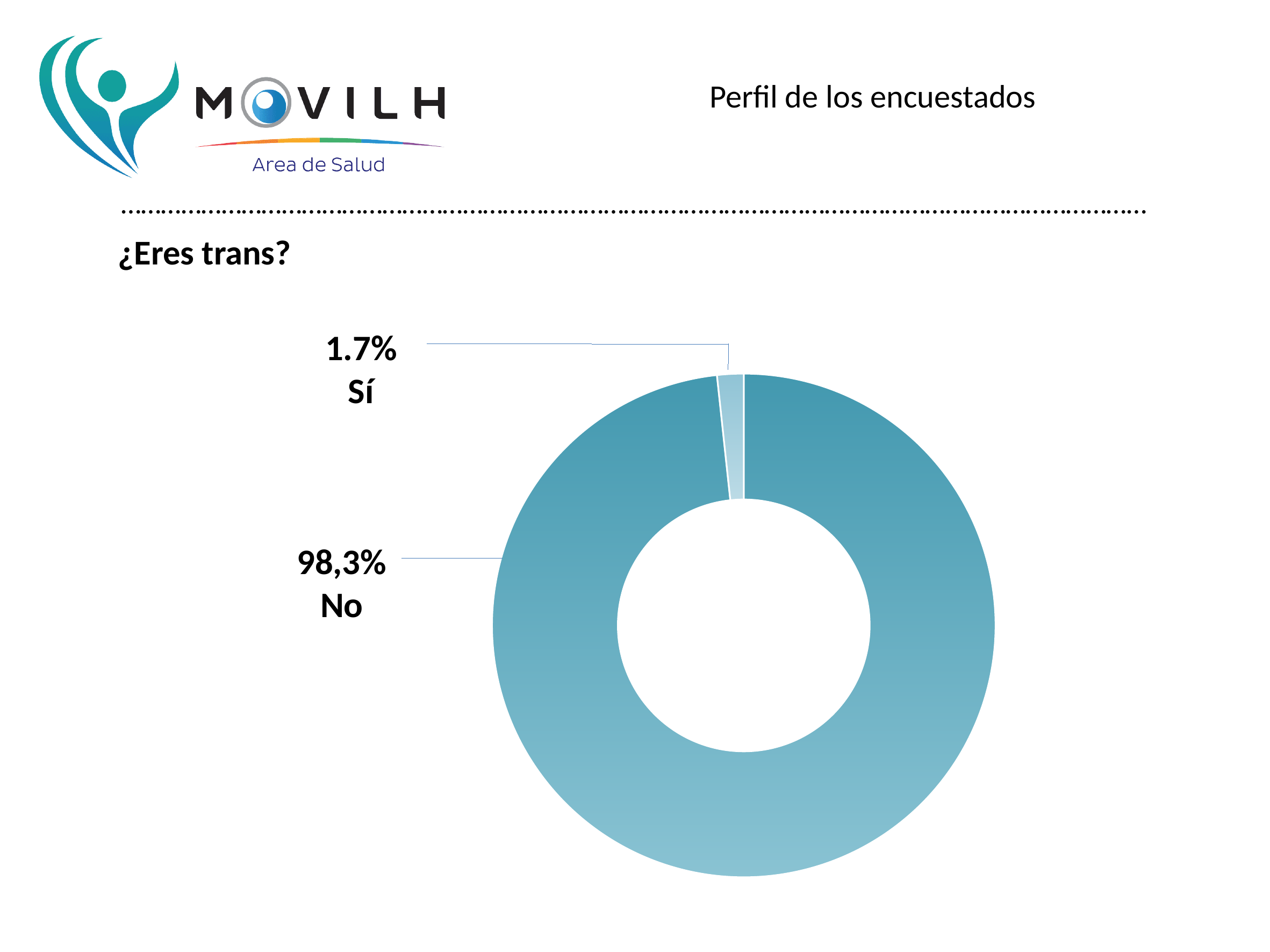
How many categories are shown in the chart? 2 What percentage of respondents answered "Sí" to "¿Eres trans?"? 1.7% Which category has the largest share of the chart? No What question does the chart on the slide answer? ¿Eres trans? What is the title shown at the top of the slide? Perfil de los encuestados What kind of chart is shown on the slide? Pie chart (donut) Which category has the smallest share of the chart? Sí Which is larger, the share for "Sí" or the share for "No"? No What percentage of respondents answered "No" to "¿Eres trans?"? 98,3%